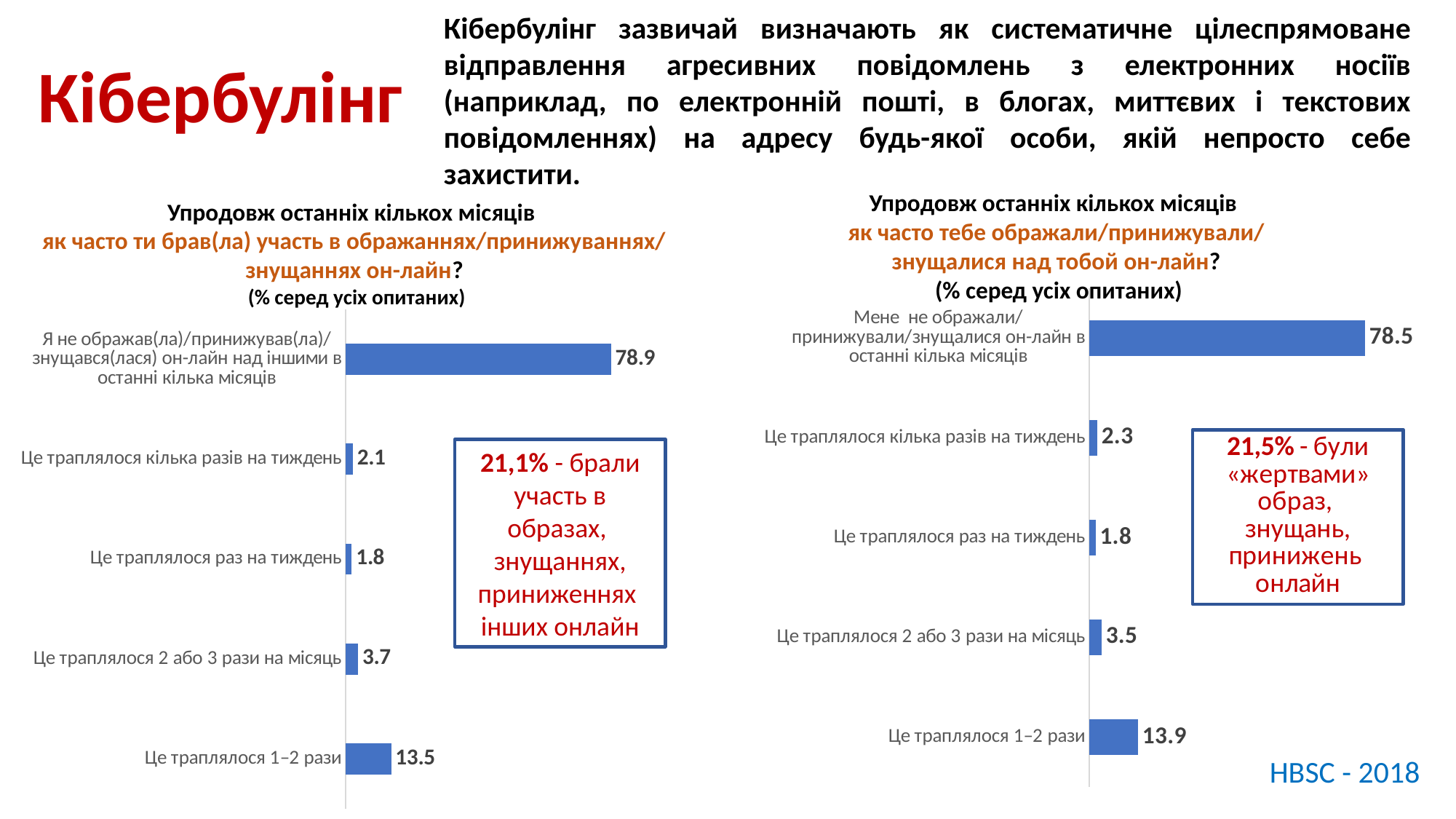
In the right chart, what is the difference between the values for "Це траплялося 1–2 рази" and "Це траплялося кілька разів на тиждень"? 11.6 What type of chart is the right chart? Bar chart How many categories does the left chart show? 5 In the left chart, what is the value for "Це траплялося 1–2 рази"? 13.5 In the right chart, which category has the lowest value? Це траплялося раз на тиждень In the left chart, which category has the highest value? Я не ображав(ла)/принижував(ла)/знущався(лася) он-лайн над іншими в останні кілька місяців In the left chart, what is the difference between the values for "Це траплялося 1–2 рази" and "Це траплялося 2 або 3 рази на місяць"? 9.8 What percentage is highlighted in the text box next to the right chart? 21,5% In the right chart, what is the value for "Це траплялося кілька разів на тиждень"? 2.3 Which is larger: the value for "Це траплялося 1–2 рази" in the left chart or in the right chart? Right chart (13.9) In the right chart, what is the value for "Це траплялося 2 або 3 рази на місяць"? 3.5 In the left chart, which category has the lowest value? Це траплялося раз на тиждень